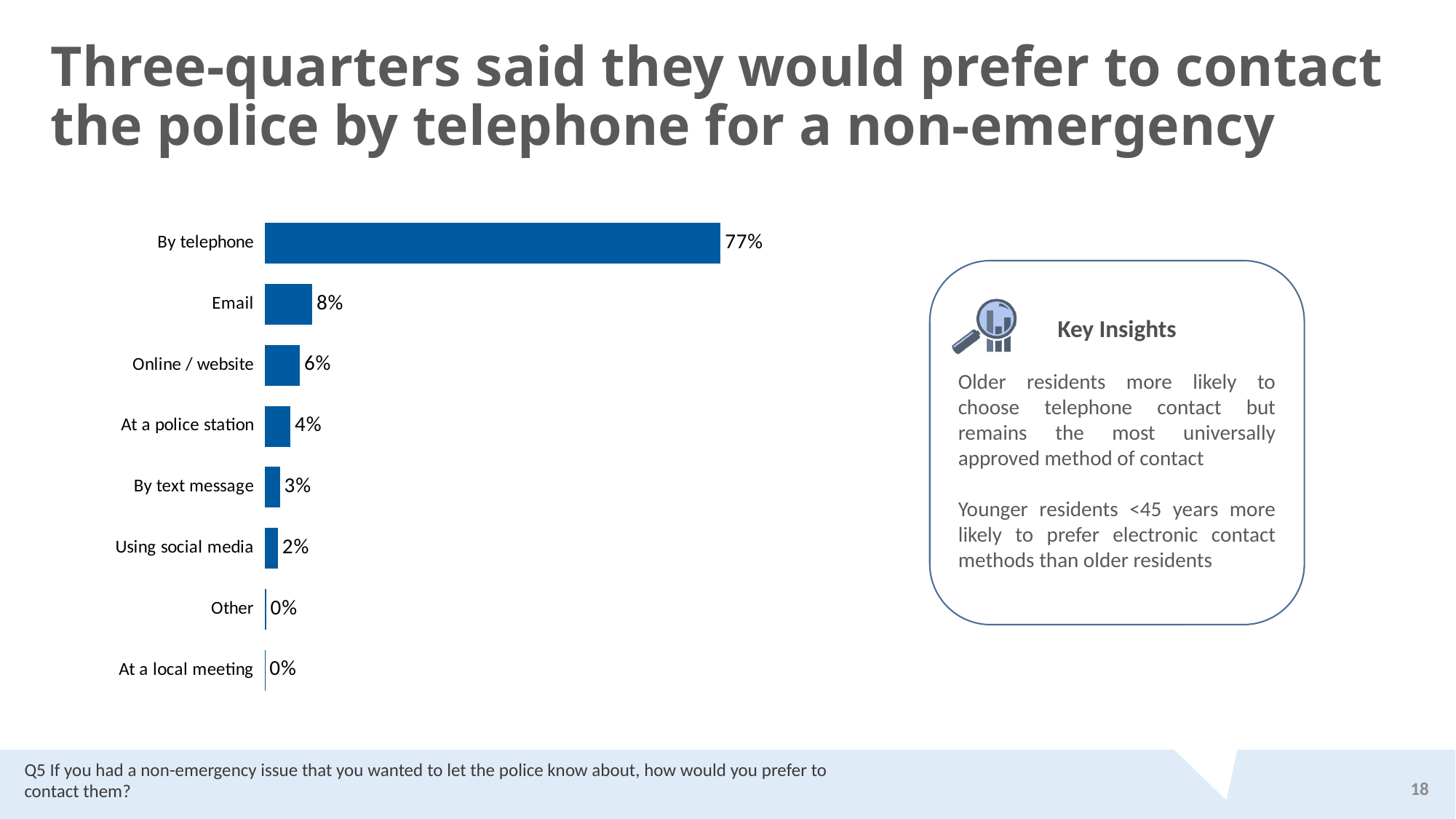
What is the value for Online / website? 6% What percentage of respondents said they would prefer to contact the police by telephone? 77% Which two categories have a value of 0%? Other and At a local meeting What is the difference between the values for By telephone and Email? 69% How many contact methods are shown in the chart? 8 What is the value for Email? 8% What is the difference between the values for Email and By text message? 5% What is the value for Using social media? 2% Which is larger, the value for Online / website or the value for At a police station? Online / website What is the value for At a police station? 4% What kind of chart is shown on the slide? Bar chart Which contact method has the highest value? By telephone